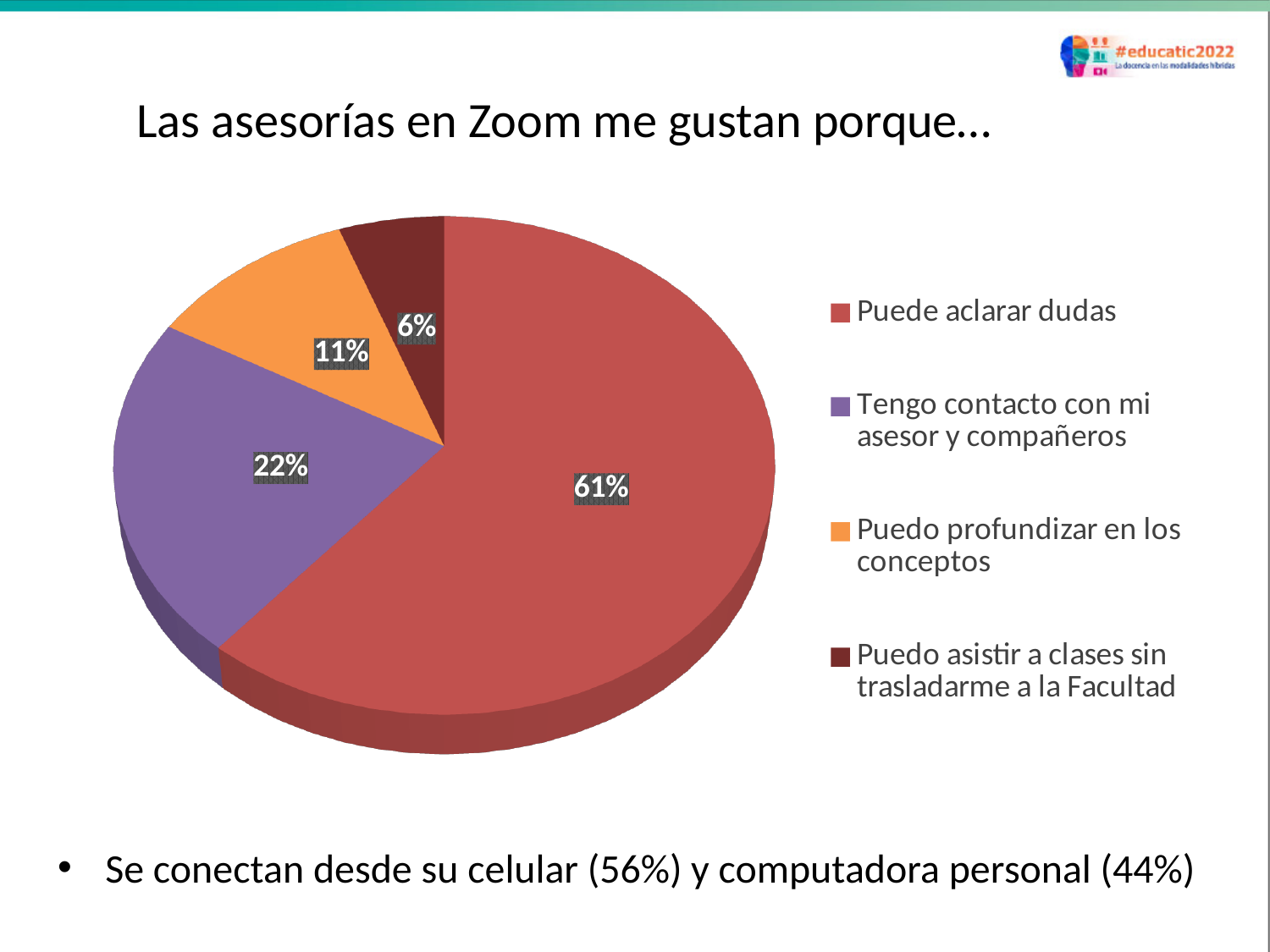
What is the difference in percentage points between "Puede aclarar dudas" and "Tengo contacto con mi asesor y compañeros"? 39 What kind of chart is shown on the slide? Pie chart Which category has the largest slice of the pie? Puede aclarar dudas How many categories does the pie chart have? 4 What colour is the slice for "Puedo profundizar en los conceptos"? Orange What share of the pie does "Puedo profundizar en los conceptos" represent? 11% What share of the pie does "Puedo asistir a clases sin trasladarme a la Facultad" represent? 6% What is the title of the slide above the chart? Las asesorías en Zoom me gustan porque… What share of the pie does "Tengo contacto con mi asesor y compañeros" represent? 22% Which category has the smallest slice of the pie? Puedo asistir a clases sin trasladarme a la Facultad Which is larger: the slice for "Puedo profundizar en los conceptos" or the slice for "Puedo asistir a clases sin trasladarme a la Facultad"? Puedo profundizar en los conceptos